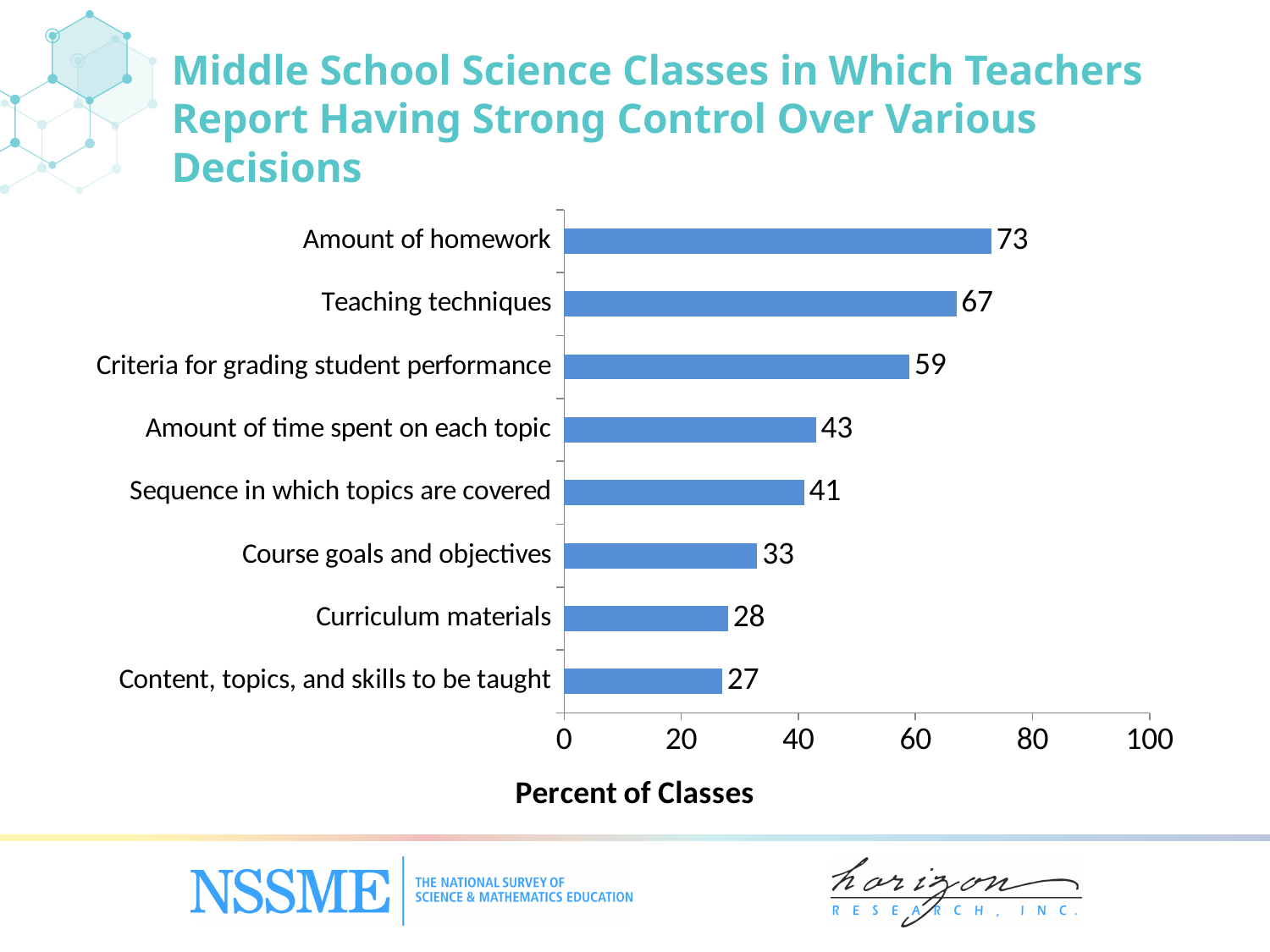
What is the value for Sequence in which topics are covered? 41 What is the difference between the highest and lowest values in the chart? 46 What is the difference between the values for Teaching techniques and Criteria for grading student performance? 8 What is the label of the horizontal axis? Percent of Classes Is the value for Amount of time spent on each topic greater or less than 40? greater How many categories are shown in the chart? 8 Which category has the lowest value? Content, topics, and skills to be taught What kind of chart is this? bar chart What is the value for Curriculum materials? 28 Which category has the highest value? Amount of homework Which is larger, the value for Course goals and objectives or the value for Curriculum materials? Course goals and objectives What percent of classes is shown for Amount of homework? 73